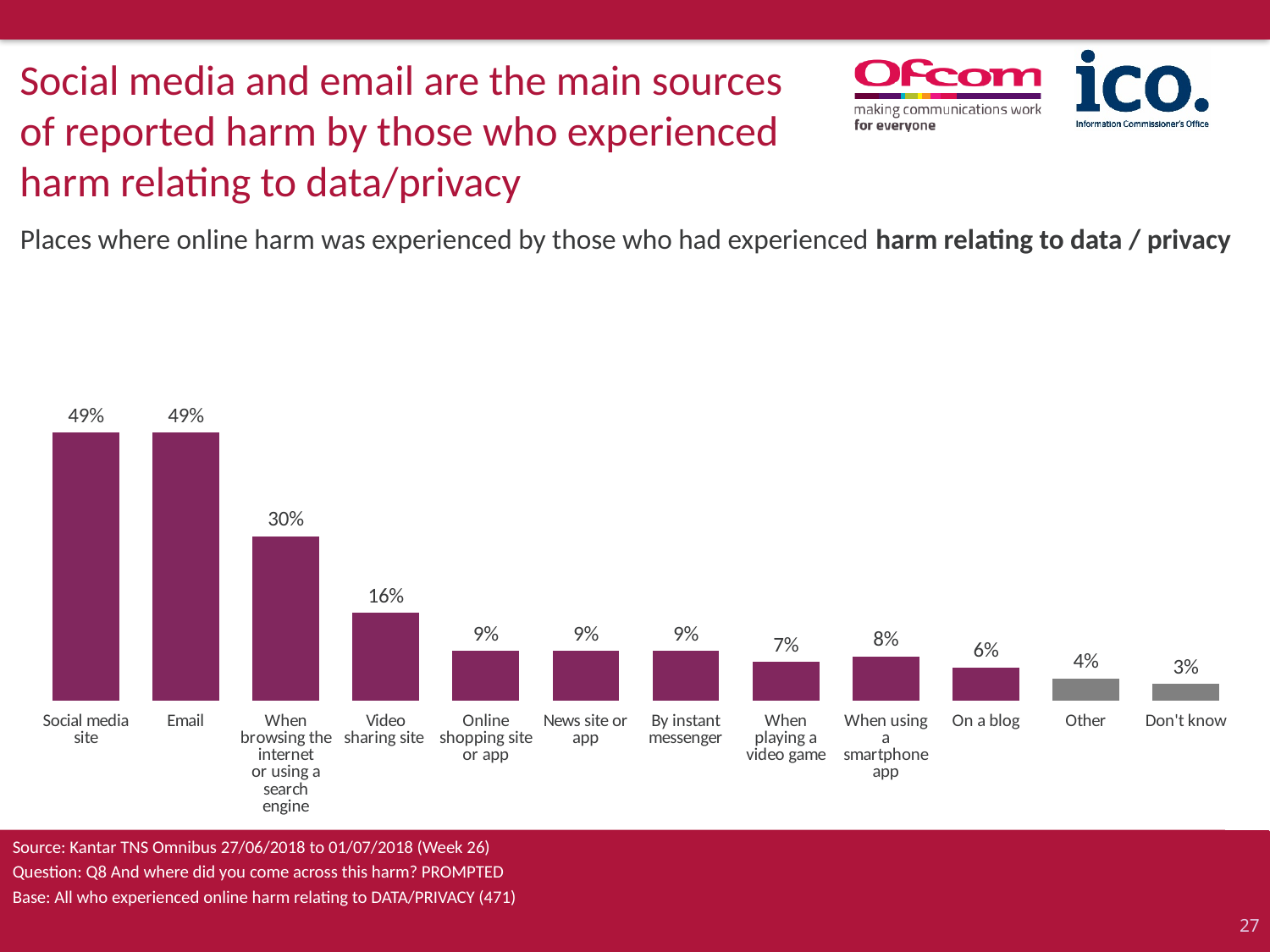
What is the value shown for 'Don't know'? 3% How many categories are shown on the chart? 12 Which category has the lowest value on the chart? Don't know Which is larger: the value for 'When playing a video game' or the value for 'When using a smartphone app'? When using a smartphone app What is the value shown for 'When browsing the internet or using a search engine'? 30% What is the value shown for 'Video sharing site'? 16% Do the values generally rise or fall moving from left to right across the chart? Fall What percentage of respondents experienced harm relating to data/privacy on a social media site? 49% Which two categories are shown with grey bars rather than purple bars? Other and Don't know What kind of chart is shown on the slide? Bar chart What is the difference between the values for 'Email' and 'When browsing the internet or using a search engine'? 19% What is the difference between the values for 'Video sharing site' and 'On a blog'? 10%